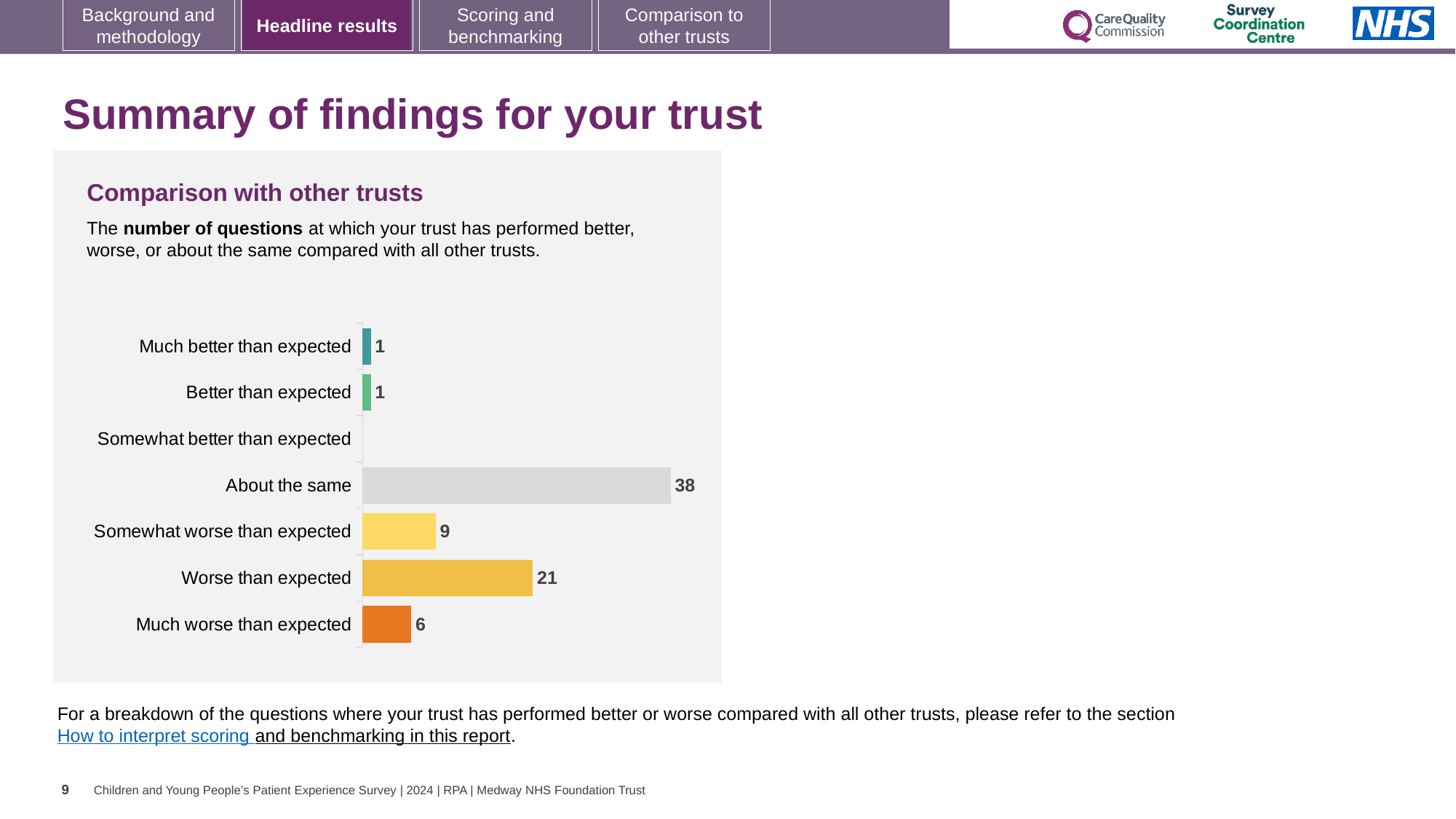
What kind of chart is shown on the slide? Bar chart What is the difference between 'Worse than expected' and 'Somewhat worse than expected'? 12 How many categories are shown on the chart? 7 What is the value for 'Much worse than expected'? 6 What is the value for 'Worse than expected'? 21 What is the total number of questions across 'Much better than expected' and 'Better than expected'? 2 How many questions were rated 'About the same'? 38 Which is larger: 'Much worse than expected' or 'Somewhat worse than expected'? Somewhat worse than expected Which category has the highest number of questions? About the same What is the value for 'Somewhat worse than expected'? 9 What colour is the bar for 'About the same'? Grey What is the title of the chart? Comparison with other trusts